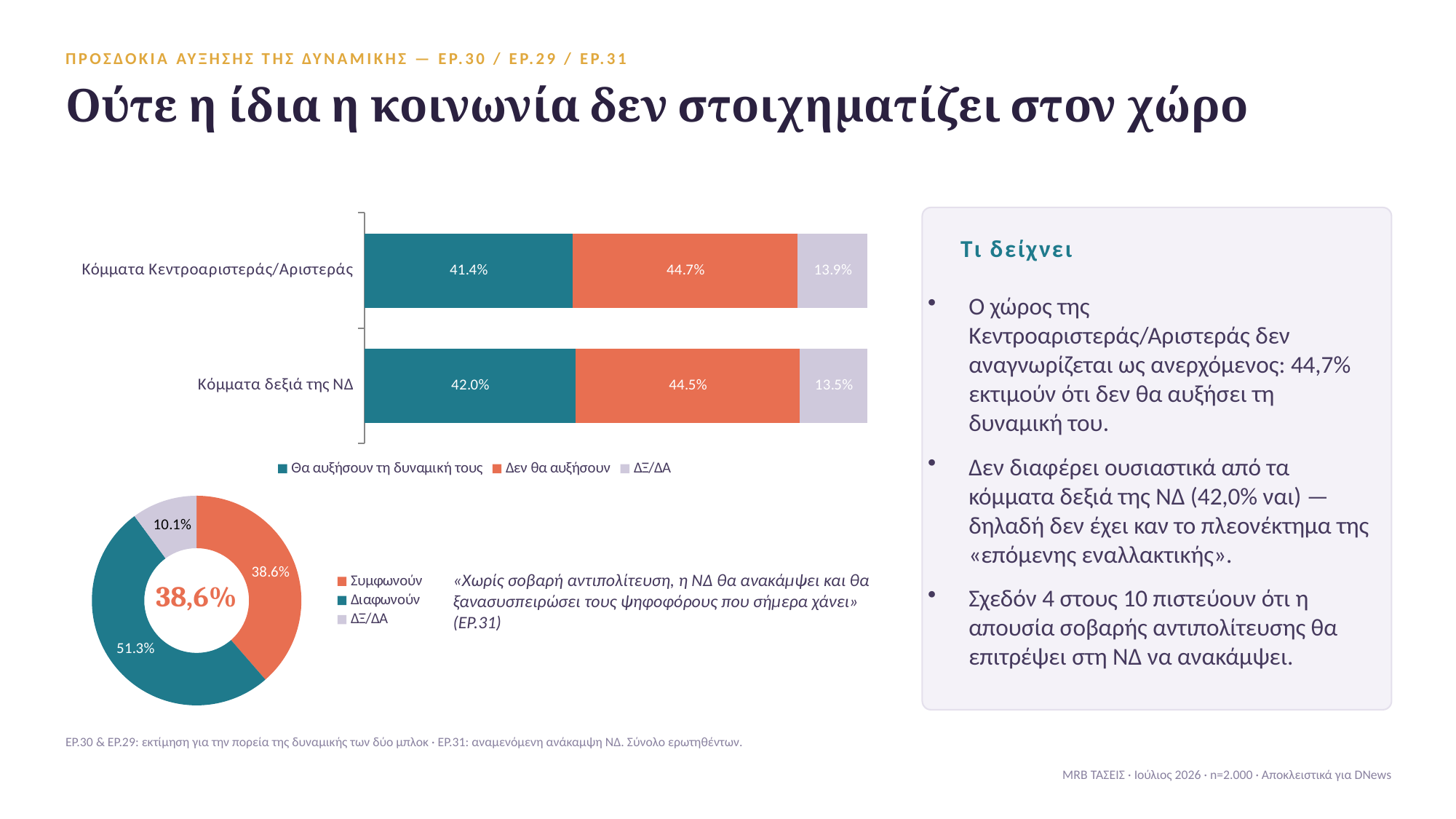
In the stacked bar chart at the top, how many series does the legend list? 3 In the stacked bar chart at the top, which category has the higher "Θα αυξήσουν τη δυναμική τους" value? Κόμματα δεξιά της ΝΔ In the donut chart at the bottom left, what value is printed in the centre of the donut? 38,6% In the stacked bar chart at the top, what is the "ΔΞ/ΔΑ" value for "Κόμματα Κεντροαριστεράς/Αριστεράς"? 13.9% In the donut chart at the bottom left, what is the share for "Διαφωνούν"? 51.3% In the stacked bar chart at the top, what is the difference between the "Δεν θα αυξήσουν" values for "Κόμματα Κεντροαριστεράς/Αριστεράς" and "Κόμματα δεξιά της ΝΔ"? 0.2% In the stacked bar chart at the top, what is the value of "Δεν θα αυξήσουν" for "Κόμματα δεξιά της ΝΔ"? 44.5% In the stacked bar chart at the top, how many categories are shown? 2 What kind of chart is the chart at the top of the slide? Stacked bar chart In the donut chart at the bottom left, what is the share for "ΔΞ/ΔΑ"? 10.1% In the donut chart at the bottom left, which slice is the largest? Διαφωνούν In the stacked bar chart at the top, what is the value of "Θα αυξήσουν τη δυναμική τους" for "Κόμματα Κεντροαριστεράς/Αριστεράς"? 41.4%